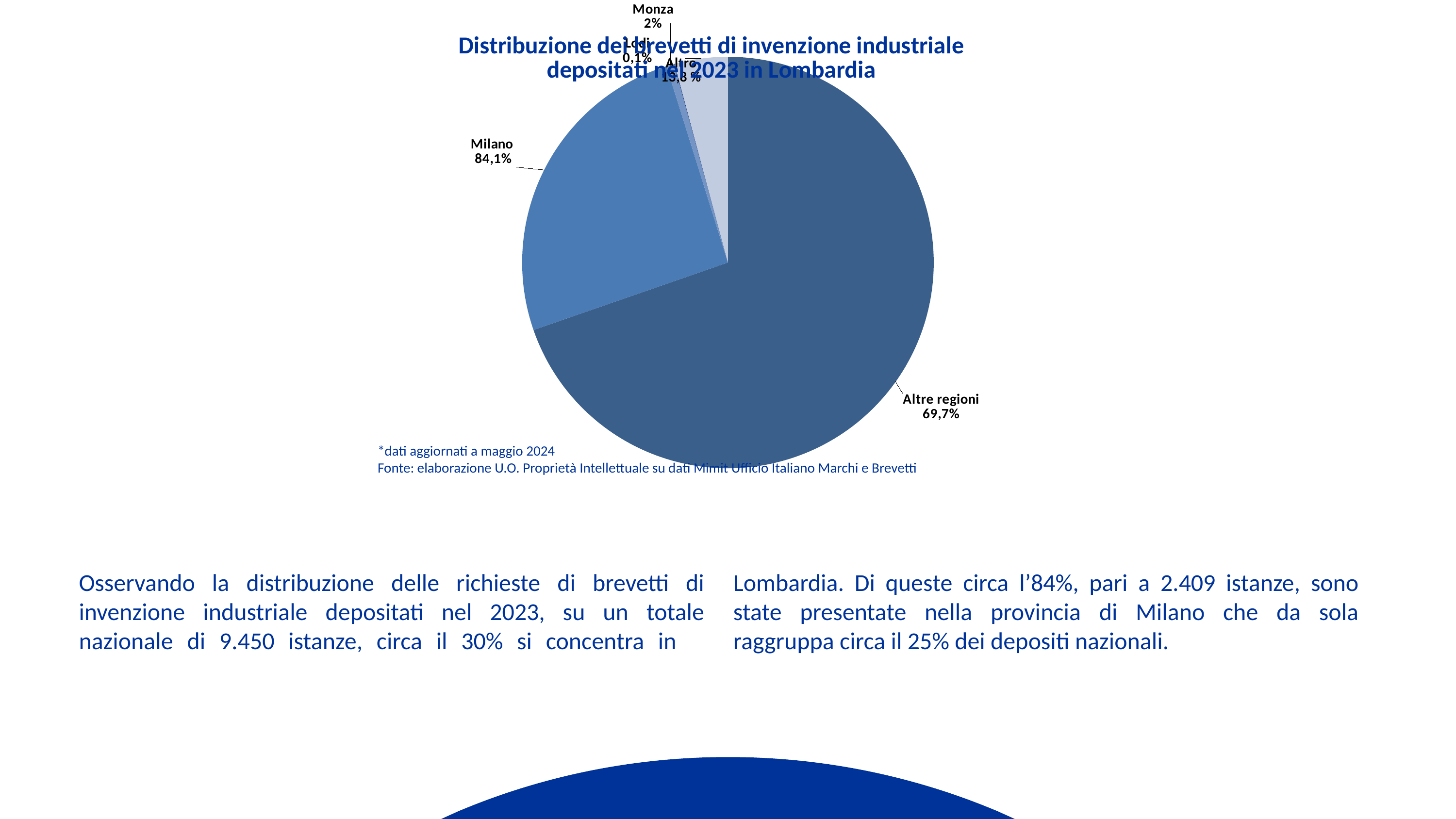
What percentage is shown for Monza? 2% What percentage is shown for Lodi? 0,1% What is the title of the chart? Distribuzione dei brevetti di invenzione industriale depositati nel 2023 in Lombardia What is the difference between the labelled values for Milano and Monza? 82,1% What kind of chart is shown on the slide? pie chart How many slices does the pie chart have? 5 Which has the larger labelled value, Milano or Monza? Milano According to the note under the chart, to which month and year are the data updated? maggio 2024 Which has the larger labelled value, Monza or Lodi? Monza What percentage is shown for Altre regioni? 69,7% What percentage is shown for Milano? 84,1% What is the difference between the labelled values for Altre regioni and Monza? 67,7%